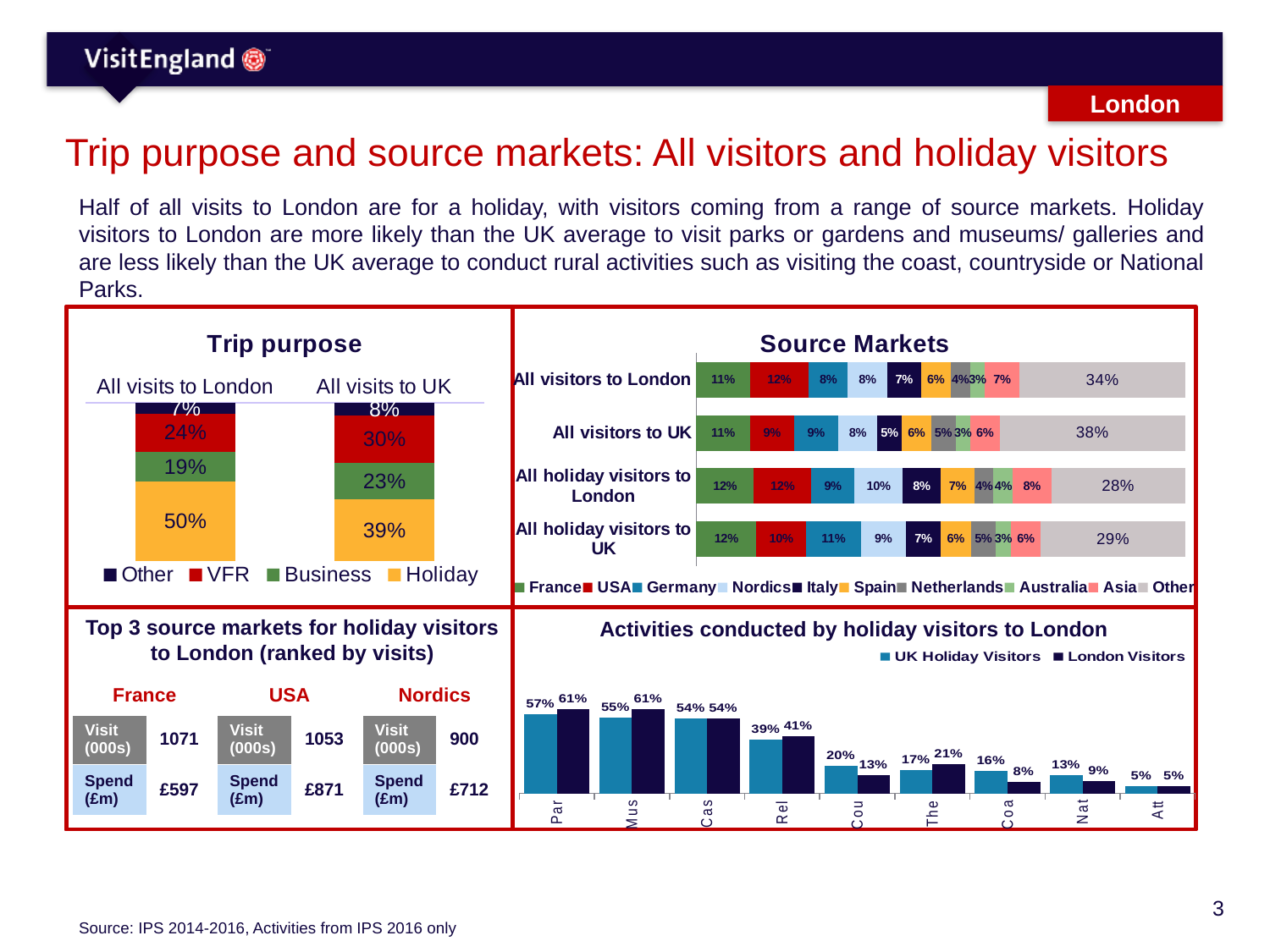
What kind of chart is the Source Markets chart? Stacked bar chart In the Activities conducted by holiday visitors to London chart, what is the London Visitors value for the first category (Par)? 61% In the Source Markets chart, what is the 'Other' share for all visitors to the UK? 38% In the Source Markets chart, which is larger for all holiday visitors to London: the Nordics share or the Germany share? Nordics In the Trip purpose chart, what is the VFR share for all visits to the UK? 30% In the Activities conducted by holiday visitors to London chart, do the UK Holiday Visitors values generally rise or fall from left to right? Fall In the Source Markets chart, how many source market series does the legend list? 10 In the Trip purpose chart, what is the difference between the Holiday share for all visits to London and for all visits to the UK? 11 percentage points In the Trip purpose chart, what share of all visits to London are for a holiday? 50% In the Source Markets chart, what share of all visitors to London come from the USA? 12% In the Activities conducted by holiday visitors to London chart, how many activity categories are shown? 9 In the Trip purpose chart, how many series does the legend list? 4